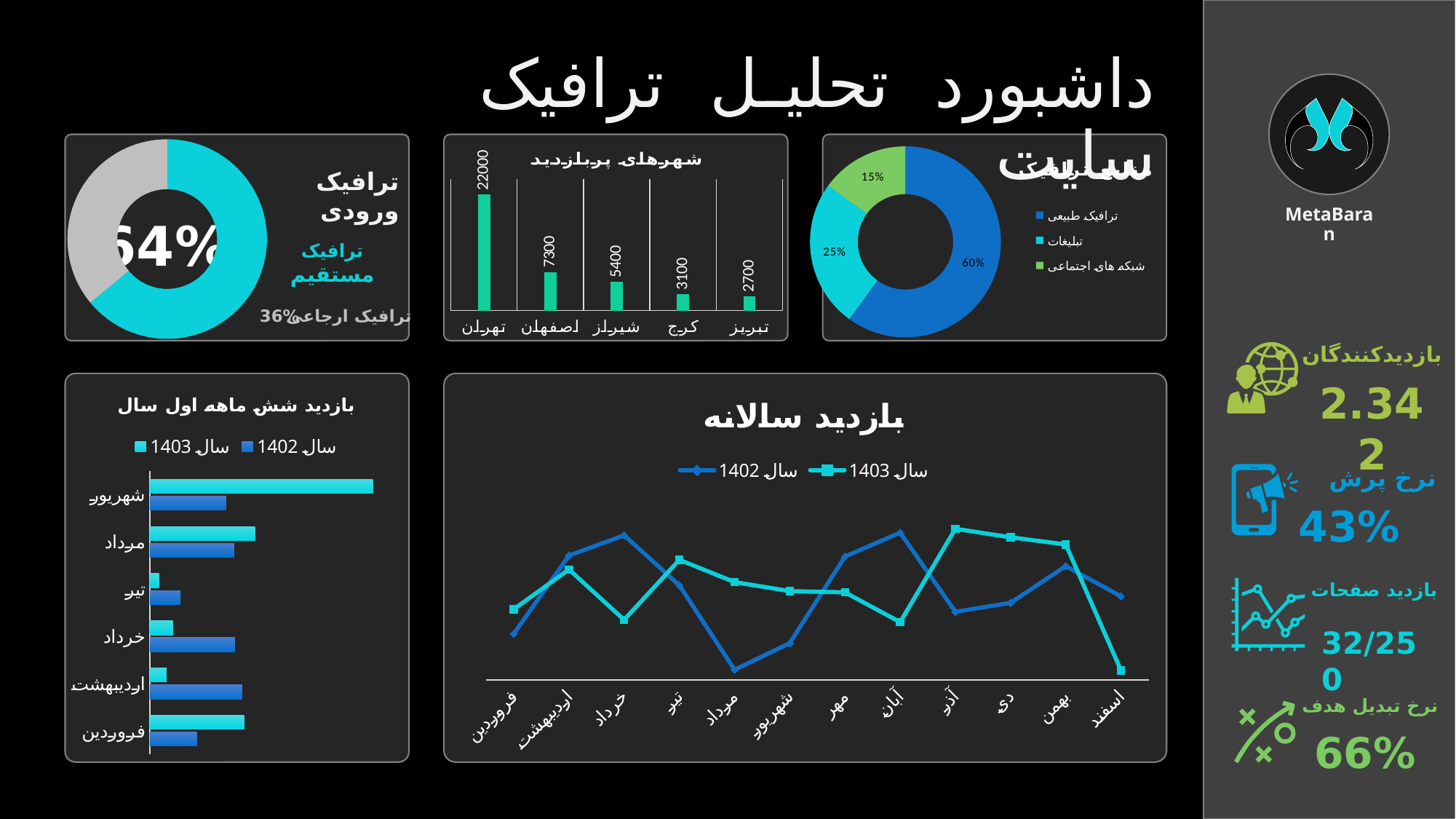
In the top-right donut chart, which legend entry has the largest share? ترافیک طبیعی What kind of chart is the chart titled "بازدید سالانه"? line chart How many series does the legend of the chart titled "بازدید سالانه" list? 2 In the chart titled "بازدید شش ماهه اول سال", which series has the larger value for شهریور, سال 1403 or سال 1402? سال 1403 In the top-left donut chart titled "ترافیک ورودی", what is the value for "ترافیک ارجاعی"? 36% How many categories are shown on the x axis of the chart titled "بازدید سالانه"? 12 How many cities are shown in the bar chart titled "شهرهای پربازدید"? 5 In the bar chart titled "شهرهای پربازدید", what is the value for تهران? 22000 In the bar chart titled "شهرهای پربازدید", which city has the lowest value? تبریز In the bar chart titled "شهرهای پربازدید", what is the difference between the values for اصفهان and کرج? 4200 In the top-right donut chart, what share does "تبلیغات" have? 25% In the bar chart titled "شهرهای پربازدید", what is the value for شیراز? 5400